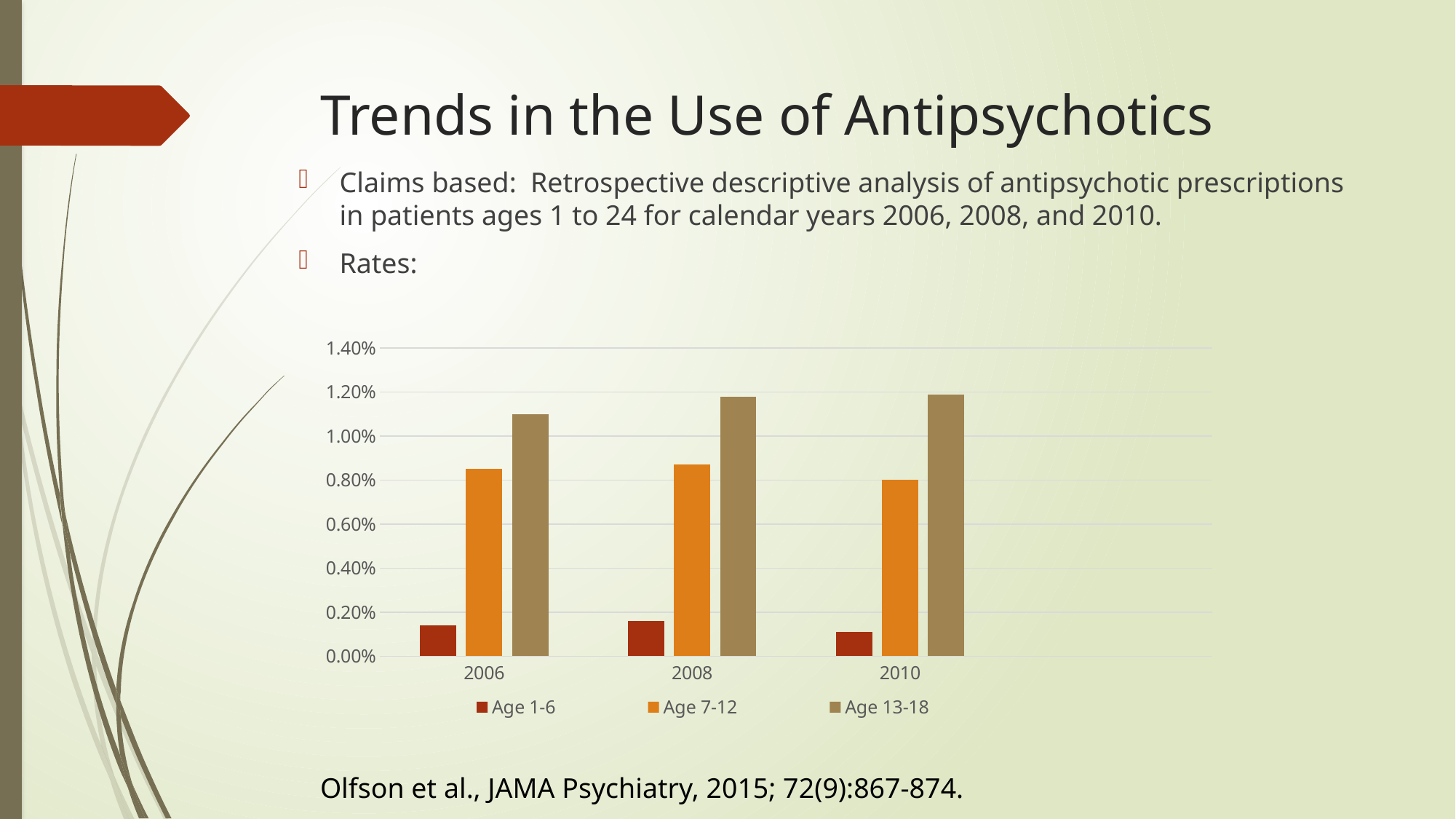
What kind of chart is shown on the slide? bar chart Is the value for Age 7-12 in 2006 greater or less than 0.60%? greater Which is larger: the Age 13-18 value in 2006 or in 2008? 2008 How many years are shown on the x axis of the chart? 3 What colour represents Age 7-12 in the chart legend? orange Is the value for Age 7-12 in 2010 greater or less than 1.00%? less How many series does the chart legend list? 3 Is the value for Age 13-18 in 2006 greater or less than 1.00%? greater Which age group has the highest rate in 2010? Age 13-18 Which age group has the lowest rate in 2006? Age 1-6 Does the Age 13-18 rate rise or fall from 2006 to 2010? rise